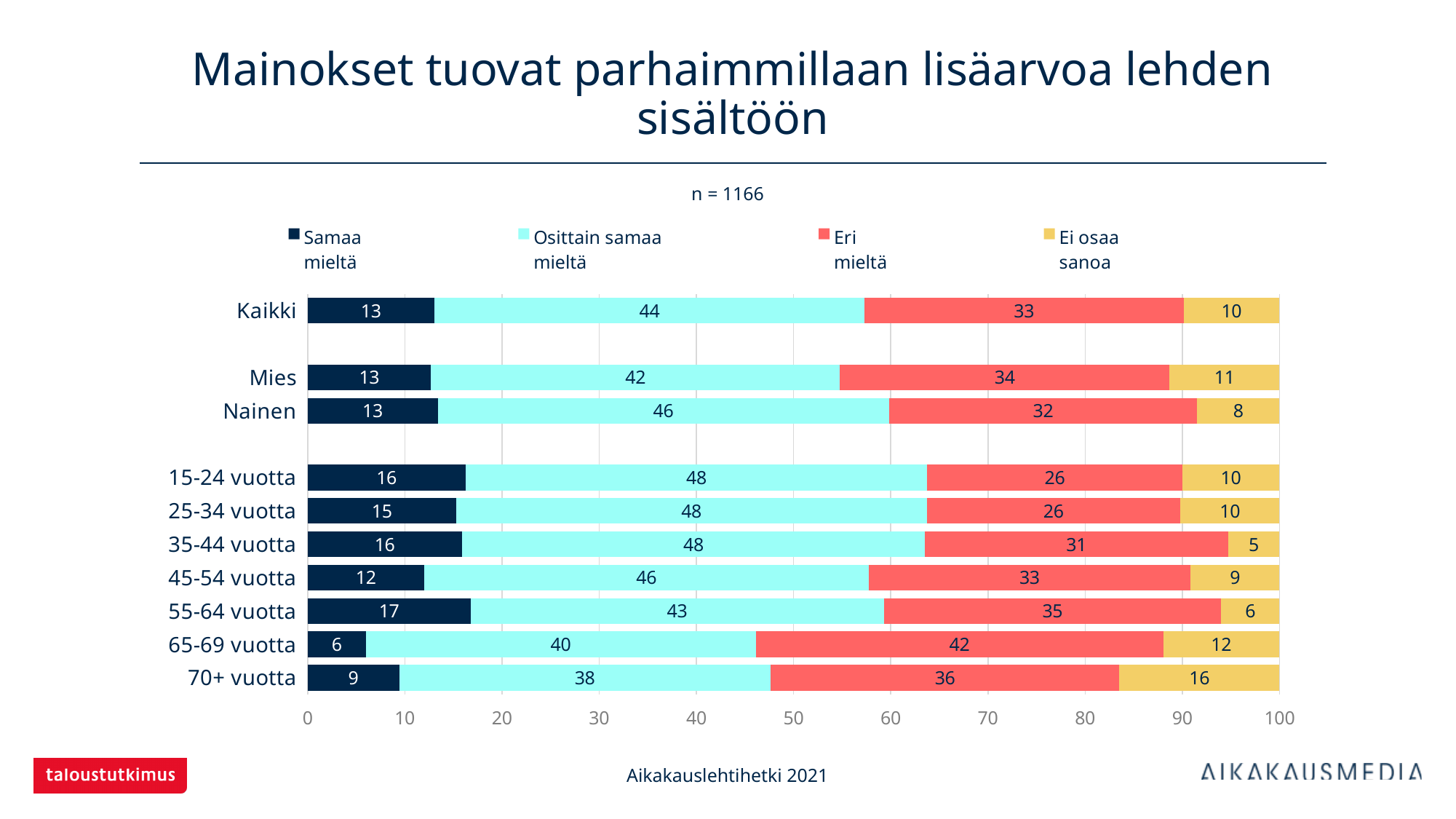
What is the value of "Osittain samaa mieltä" for Nainen? 46 What is the difference between the "Eri mieltä" values for 65-69 vuotta and 15-24 vuotta? 16 Which category has the highest value for "Samaa mieltä"? 55-64 vuotta What kind of chart is shown on the slide? Stacked bar chart Which category has the lowest value for "Ei osaa sanoa"? 35-44 vuotta How many categories are shown on the chart? 10 How many series does the legend list? 4 Which is larger: the "Osittain samaa mieltä" value for Mies or for Nainen? Nainen Which category has the lowest value for "Samaa mieltä"? 65-69 vuotta What is the value of "Ei osaa sanoa" for 70+ vuotta? 16 What is the value of "Eri mieltä" for the 65-69 vuotta category? 42 What is the total of the stacked bar for Kaikki? 100